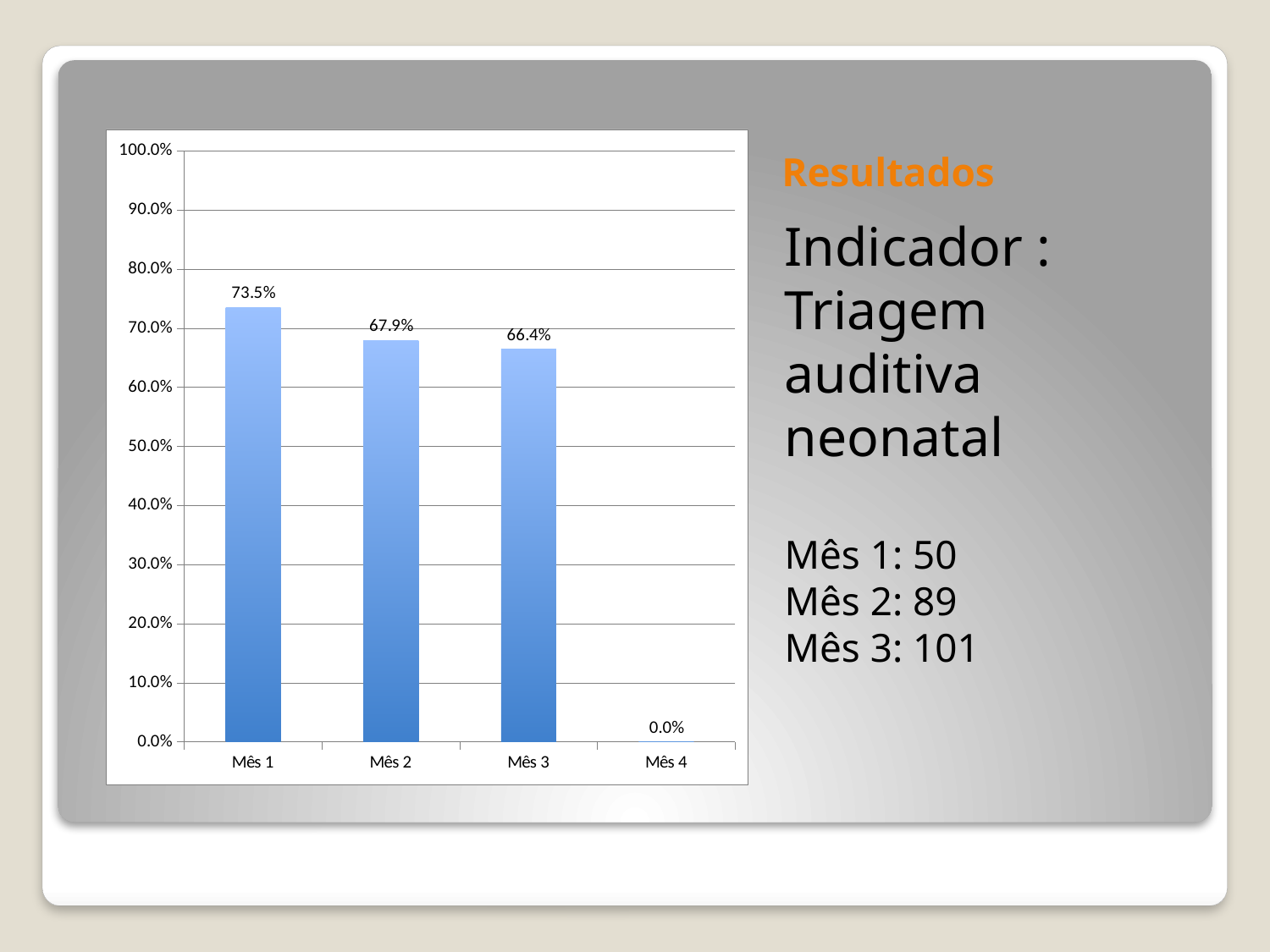
What is the value for Mês 4? 0.0% Which is larger, the value for Mês 1 or the value for Mês 3? Mês 1 How many categories are shown on the x axis? 4 What kind of chart is shown on the slide? Bar chart What is the value for Mês 3? 66.4% What is the value for Mês 1? 73.5% What is the difference between the values for Mês 2 and Mês 3? 1.5% Which month has the highest value? Mês 1 What is the difference between the values for Mês 1 and Mês 2? 5.6% Which month has the lowest value? Mês 4 Is the value for Mês 2 greater or less than 70.0%? less What is the value for Mês 2? 67.9%